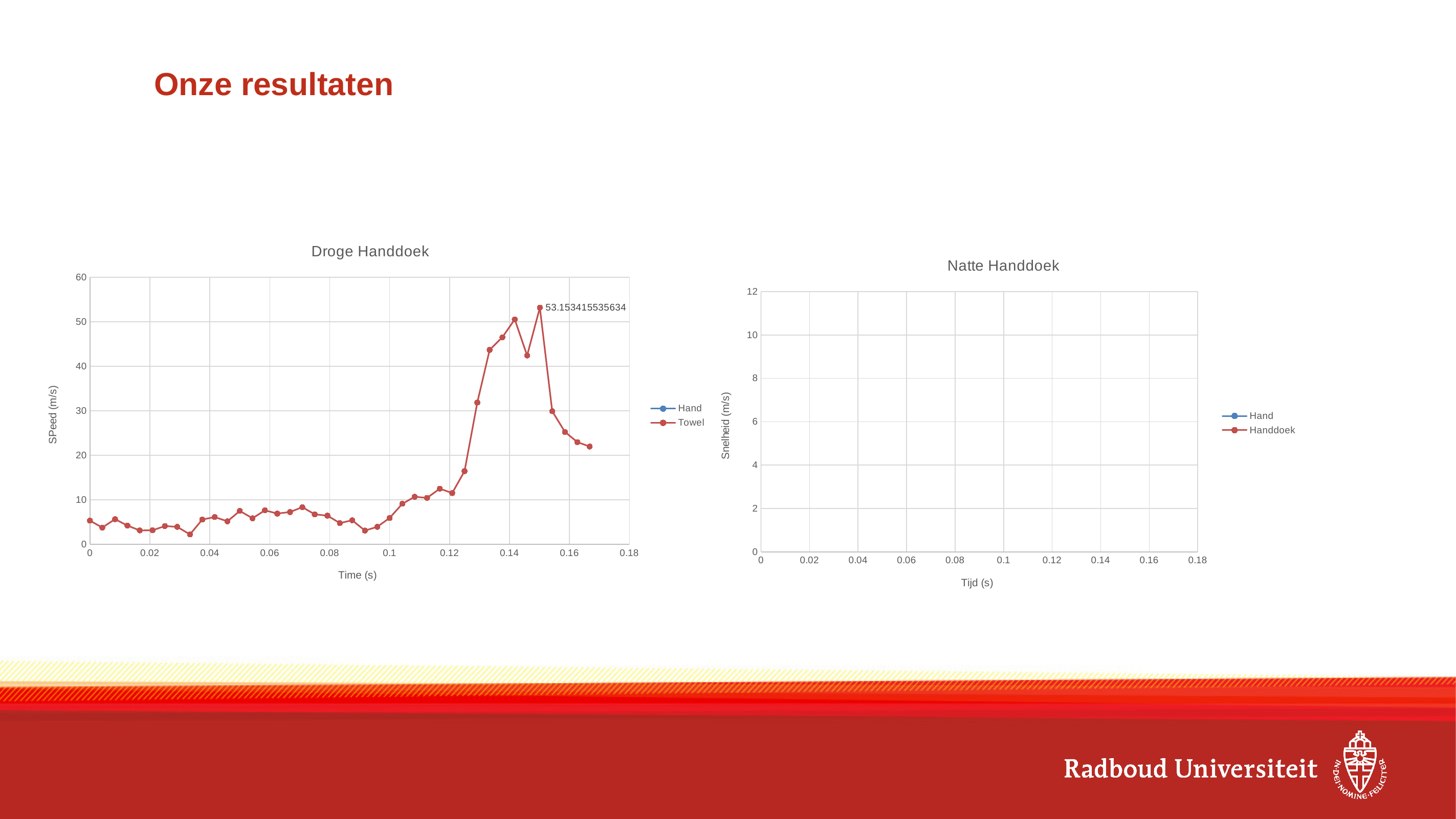
What is the y-axis label of the 'Droge Handdoek' chart? SPeed (m/s) In the 'Droge Handdoek' chart, what is the highest value reached by the Towel series? 53.153415535634 In the 'Droge Handdoek' chart, does the Towel series rise or fall between time 0.12 and time 0.15? rise In the 'Droge Handdoek' chart, is the Towel value at time 0.1 greater or less than 10? less What are the two legend entries of the 'Natte Handdoek' chart? Hand and Handdoek How many series does the legend of the 'Droge Handdoek' chart list? 2 In the 'Droge Handdoek' chart, is the Towel value at time 0 greater or less than 10? less What kind of chart is the 'Droge Handdoek' chart? line chart In the 'Droge Handdoek' chart, which is larger: the Towel value at time 0.13 or at time 0.16? 0.13 In the 'Droge Handdoek' chart, is the Towel value at time 0.16 greater or less than 20? greater How many series does the legend of the 'Natte Handdoek' chart list? 2